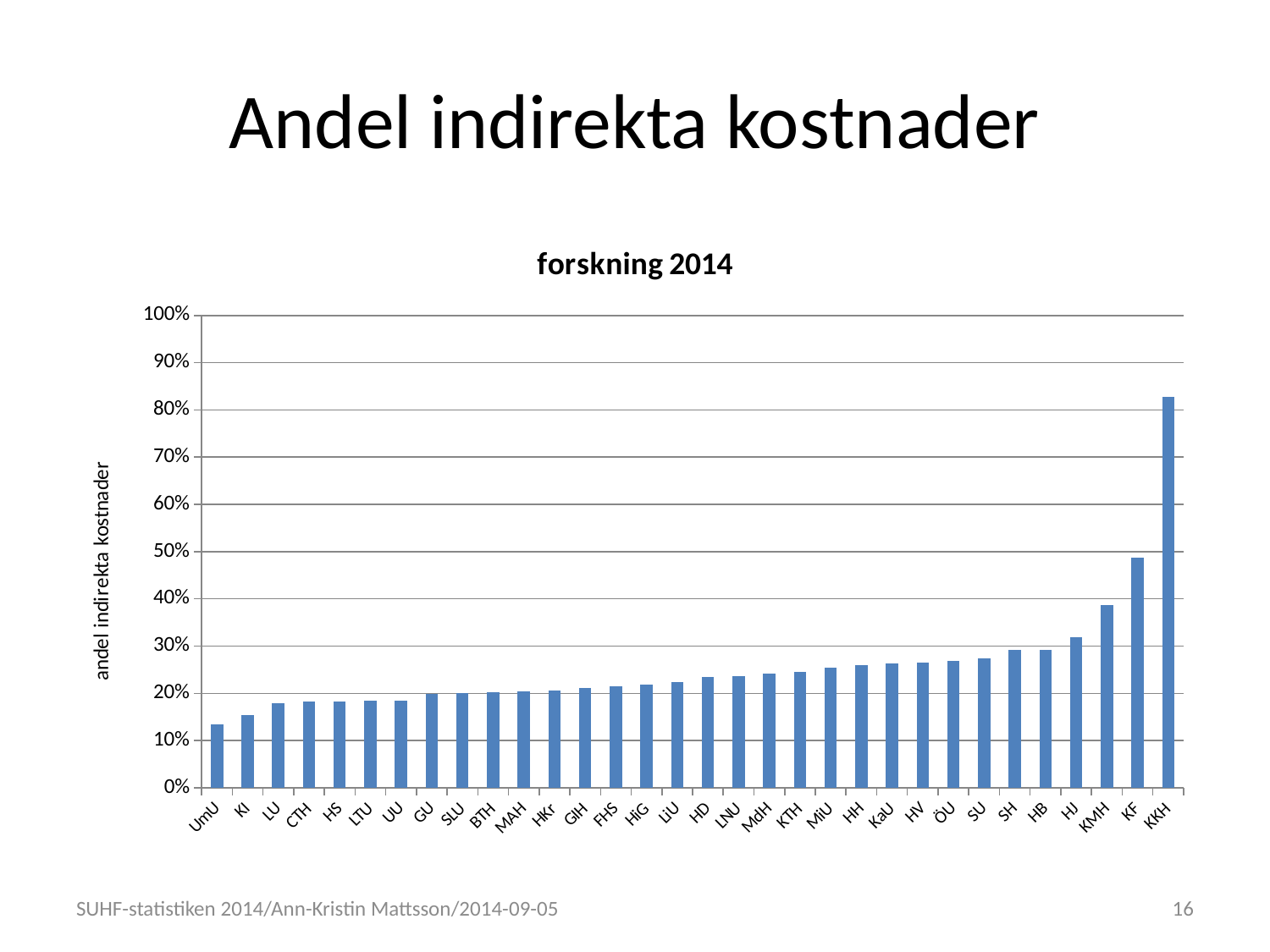
How many categories (institutions) are plotted on the x axis? 32 Is the value for KKH greater or less than 80%? greater Is the value for KMH greater or less than 40%? less Is the value for KF greater or less than 50%? less Which has the larger value, KF or KMH? KF What kind of chart is shown on the slide? bar chart Do the values generally rise or fall moving from left to right along the x axis? rise Which institution has the highest share of indirect costs? KKH Which institution has the lowest share of indirect costs? UmU What is the title of the chart? forskning 2014 What is the label on the vertical axis of the chart? andel indirekta kostnader